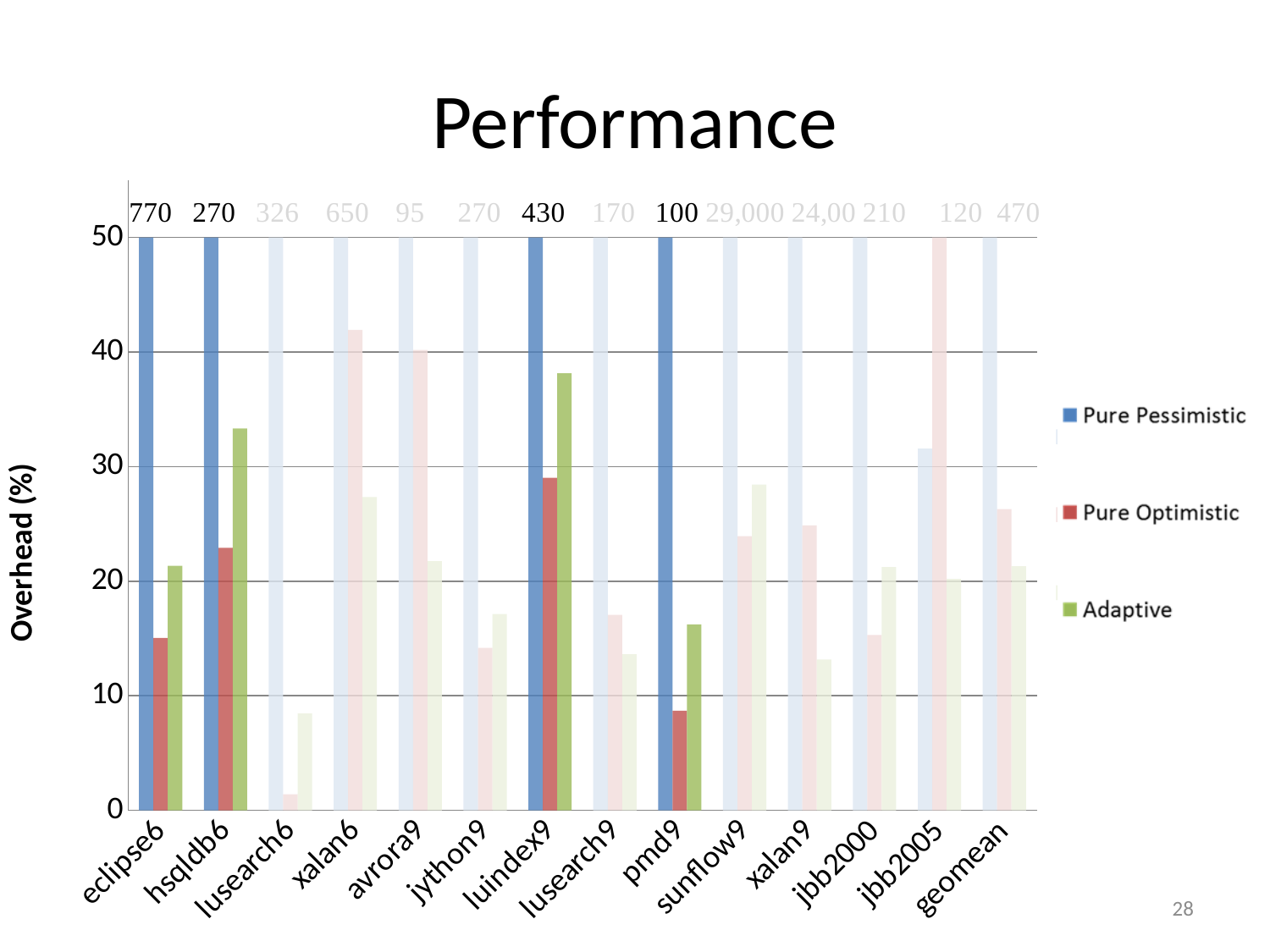
Which series are listed in the legend? Pure Pessimistic, Pure Optimistic, Adaptive What is the difference between the printed Pure Pessimistic values for eclipse6 and hsqldb6? 500 How many series does the legend list? 3 How many benchmark categories are shown on the x axis? 14 What is the label on the y axis? Overhead (%) Which benchmark has the highest printed Pure Pessimistic value? sunflow9 What value is printed above the Pure Pessimistic bar for eclipse6? 770 Is the Adaptive value for luindex9 greater or less than 30? greater What kind of chart is shown on the slide? bar chart For hsqldb6, which is larger: the Pure Optimistic value or the Adaptive value? Adaptive What value is printed above the Pure Pessimistic bar for luindex9? 430 Which benchmark has the lowest printed Pure Pessimistic value? avrora9